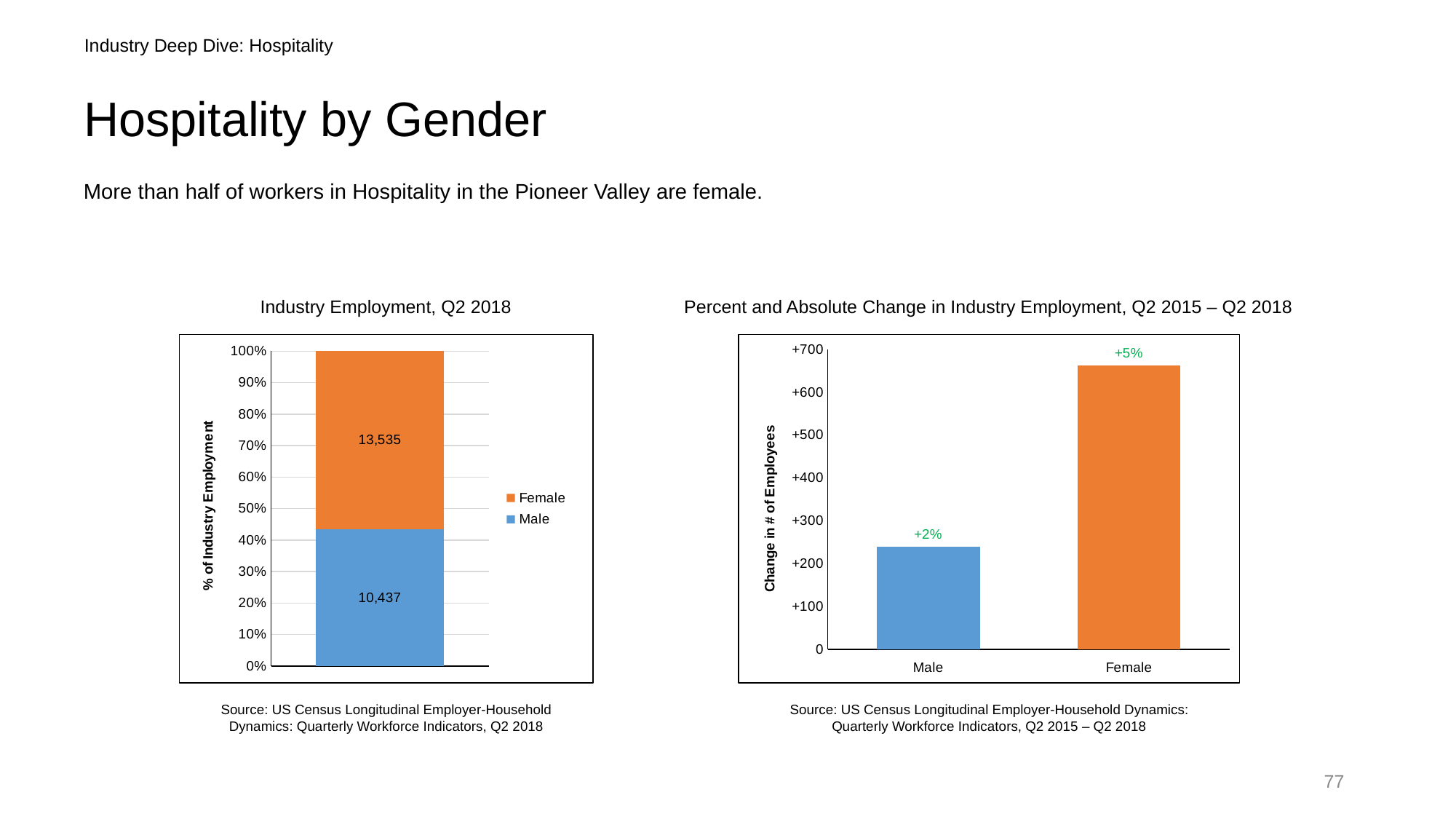
In the 'Percent and Absolute Change in Industry Employment, Q2 2015 – Q2 2018' chart, which category has the highest change in number of employees? Female In the 'Industry Employment, Q2 2018' chart, how many series does the legend list? 2 In the 'Percent and Absolute Change in Industry Employment, Q2 2015 – Q2 2018' chart, what percent change is labelled above the Female bar? +5% In the 'Industry Employment, Q2 2018' chart, what is the difference between the Female and Male values? 3,098 In the 'Industry Employment, Q2 2018' chart, which segment is larger, Female or Male? Female In the 'Industry Employment, Q2 2018' chart, what is the total of the stacked bar (Female plus Male)? 23,972 In the 'Industry Employment, Q2 2018' chart, what is the value labelled on the Female segment? 13,535 In the 'Percent and Absolute Change in Industry Employment, Q2 2015 – Q2 2018' chart, is the change in number of employees for Male greater or less than +300? less In the 'Percent and Absolute Change in Industry Employment, Q2 2015 – Q2 2018' chart, is the change in number of employees for Female greater or less than +600? greater In the 'Industry Employment, Q2 2018' chart, what is the y-axis title? % of Industry Employment In the 'Industry Employment, Q2 2018' chart, what is the value labelled on the Male segment? 10,437 In the 'Percent and Absolute Change in Industry Employment, Q2 2015 – Q2 2018' chart, what percent change is labelled above the Male bar? +2%